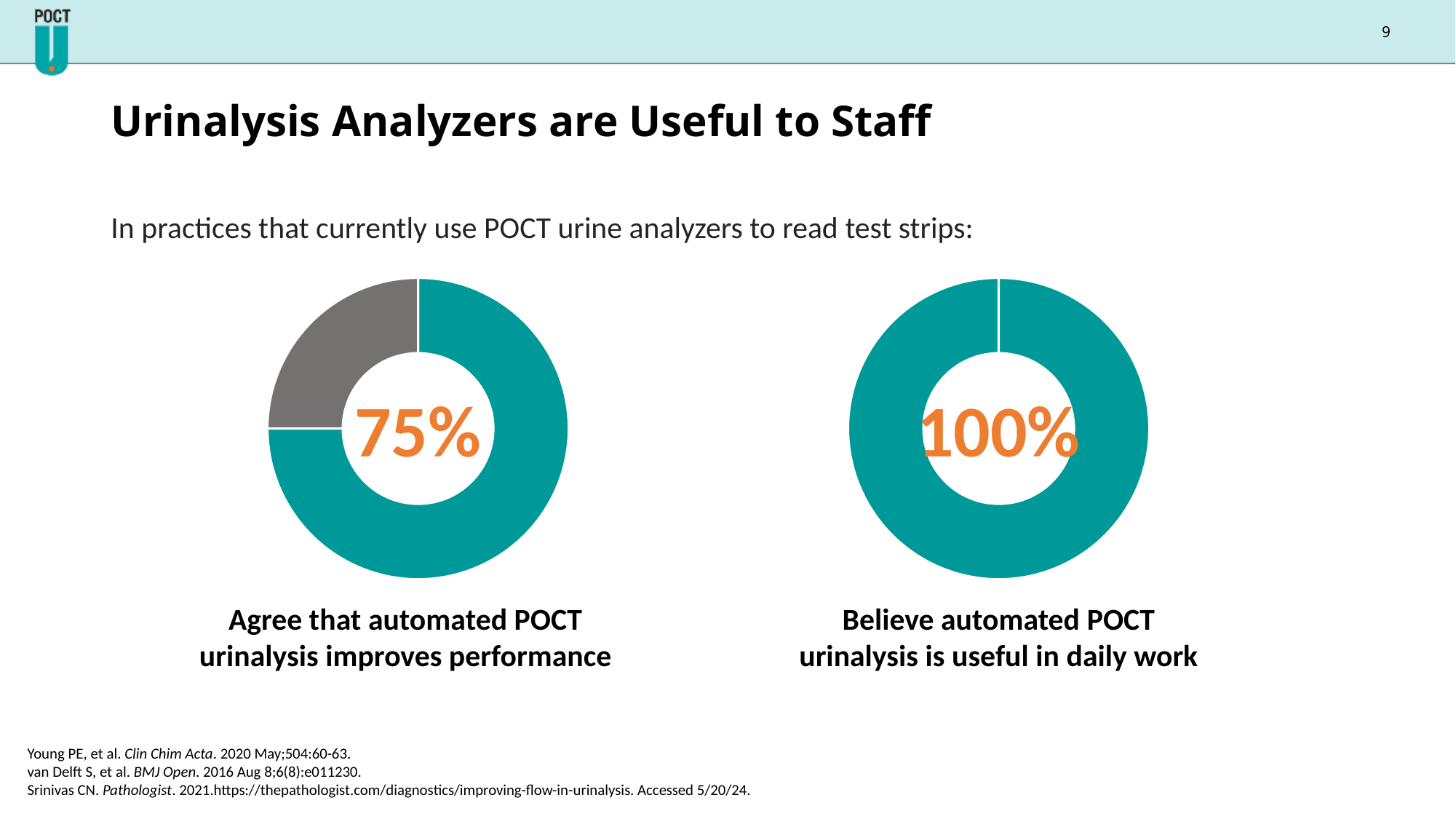
Is the value shown in the left donut chart greater or less than 50%? greater What is the caption under the right donut chart? Believe automated POCT urinalysis is useful in daily work How many donut charts are shown on the slide? 2 On the left donut chart, what share of the ring is shown in grey (the portion not agreeing)? 25% What colour is used for the filled portion of both donut charts? Teal Which of the two donut charts shows the lowest percentage? The left chart (Agree that automated POCT urinalysis improves performance), 75% Which is larger: the share who agree automated POCT urinalysis improves performance, or the share who believe it is useful in daily work? Believe it is useful in daily work (100%) On the right donut chart, what percentage believe automated POCT urinalysis is useful in daily work? 100% What kind of chart is used to show the 75% value on the left? Donut (pie) chart What is the difference in percentage points between the right chart's value (100%) and the left chart's value (75%)? 25 percentage points On the left donut chart, what percentage agree that automated POCT urinalysis improves performance? 75%